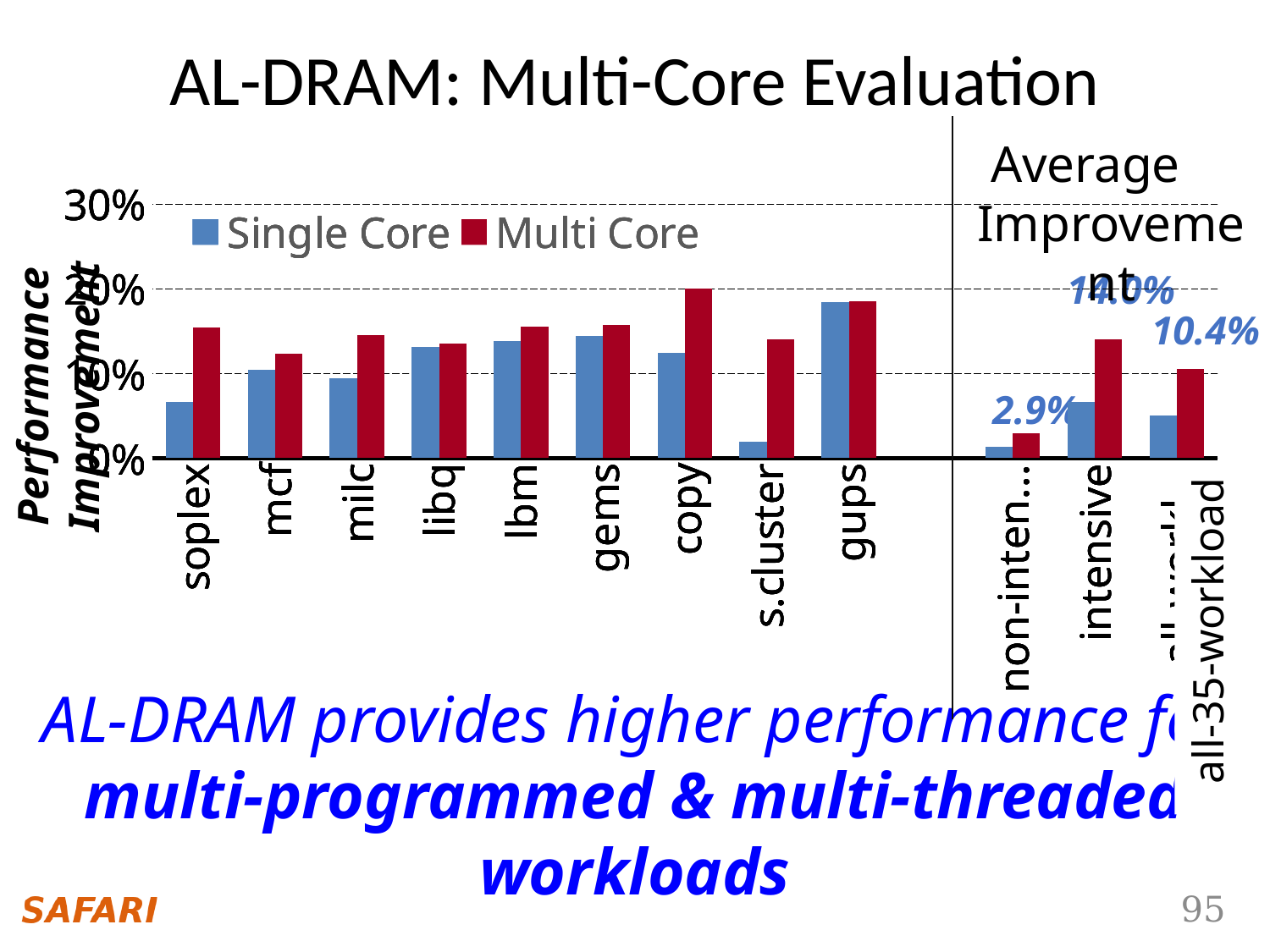
Is the Single Core performance improvement for s.cluster greater or less than 10%? less How many series does the chart legend list? 2 What value is labelled on the Multi Core bar for the all-35-workload group? 10.4% For soplex, which is larger: the Single Core or the Multi Core performance improvement? Multi Core Among the nine individual benchmarks (soplex through gups), which has the lowest Single Core performance improvement? s.cluster Is the Single Core performance improvement for gups greater or less than 10%? greater What kind of chart is shown on the slide? bar chart Which benchmark has the highest Single Core performance improvement? gups What value is labelled on the Multi Core bar for the non-intensive workload group? 2.9% What are the two series named in the chart legend? Single Core and Multi Core What is the title of the slide containing the chart? AL-DRAM: Multi-Core Evaluation What value is labelled on the Multi Core bar for the intensive workload group? 14.0%